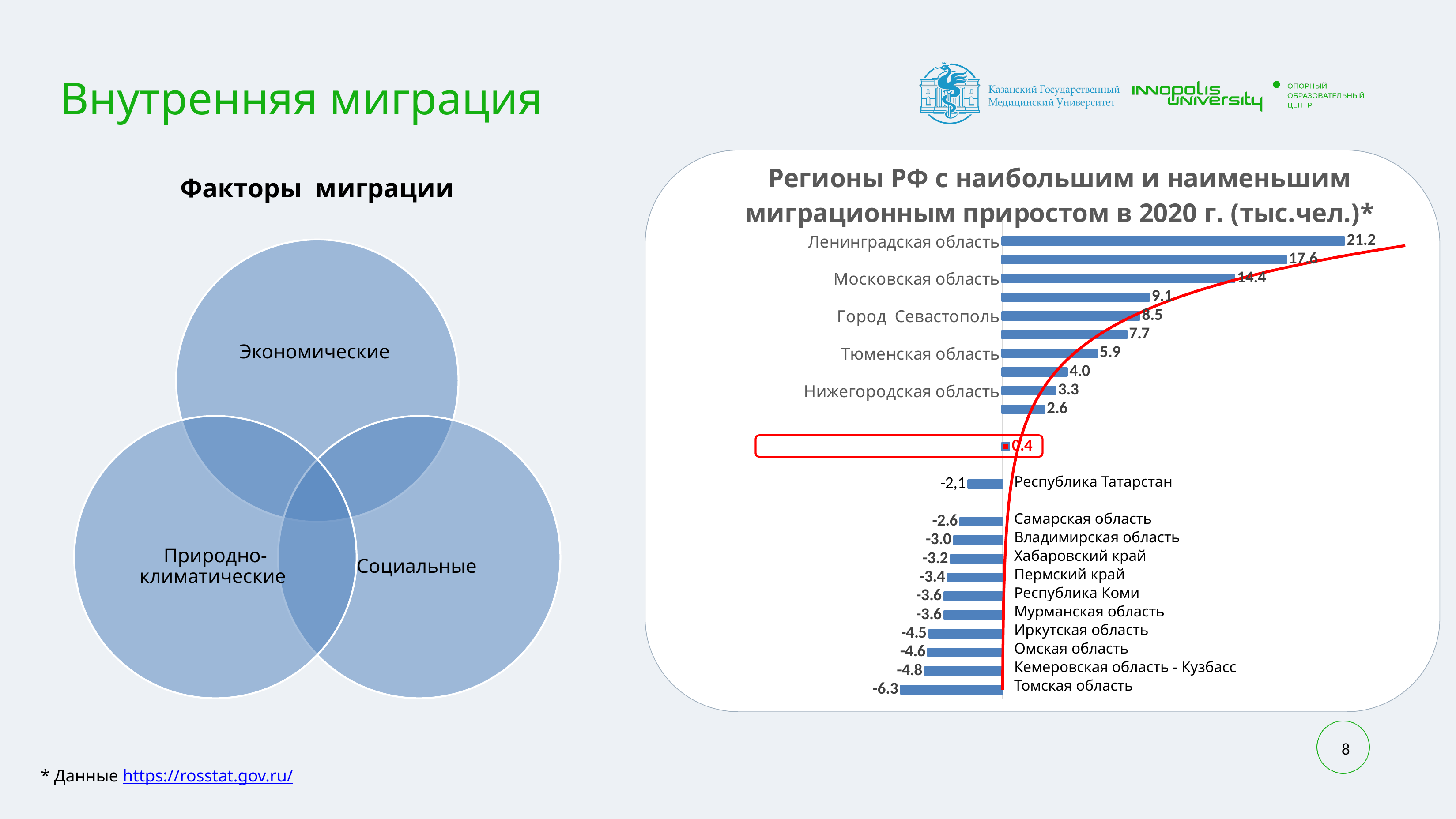
In the bar chart on the right, what is the value for Город Севастополь? 8.5 In the bar chart on the right, what is the value for Томская область? -6.3 In the bar chart on the right, which is larger: the value for Тюменская область or Нижегородская область? Тюменская область In the bar chart on the right, which region has the highest migration gain? Ленинградская область In the bar chart on the right, what is the value for Ленинградская область? 21.2 What is the title of the chart on the right side of the slide? Регионы РФ с наибольшим и наименьшим миграционным приростом в 2020 г. (тыс.чел.)* What kind of chart is shown on the right side of the slide? Bar chart In the bar chart on the right, which region has the lowest value? Томская область In the bar chart on the right, what is the difference between the values for Ленинградская область and Московская область? 6.8 In the bar chart on the right, what is the value for Московская область? 14.4 In the bar chart on the right, what is the value for Республика Татарстан? -2,1 How many bars are plotted in the bar chart on the right? 22